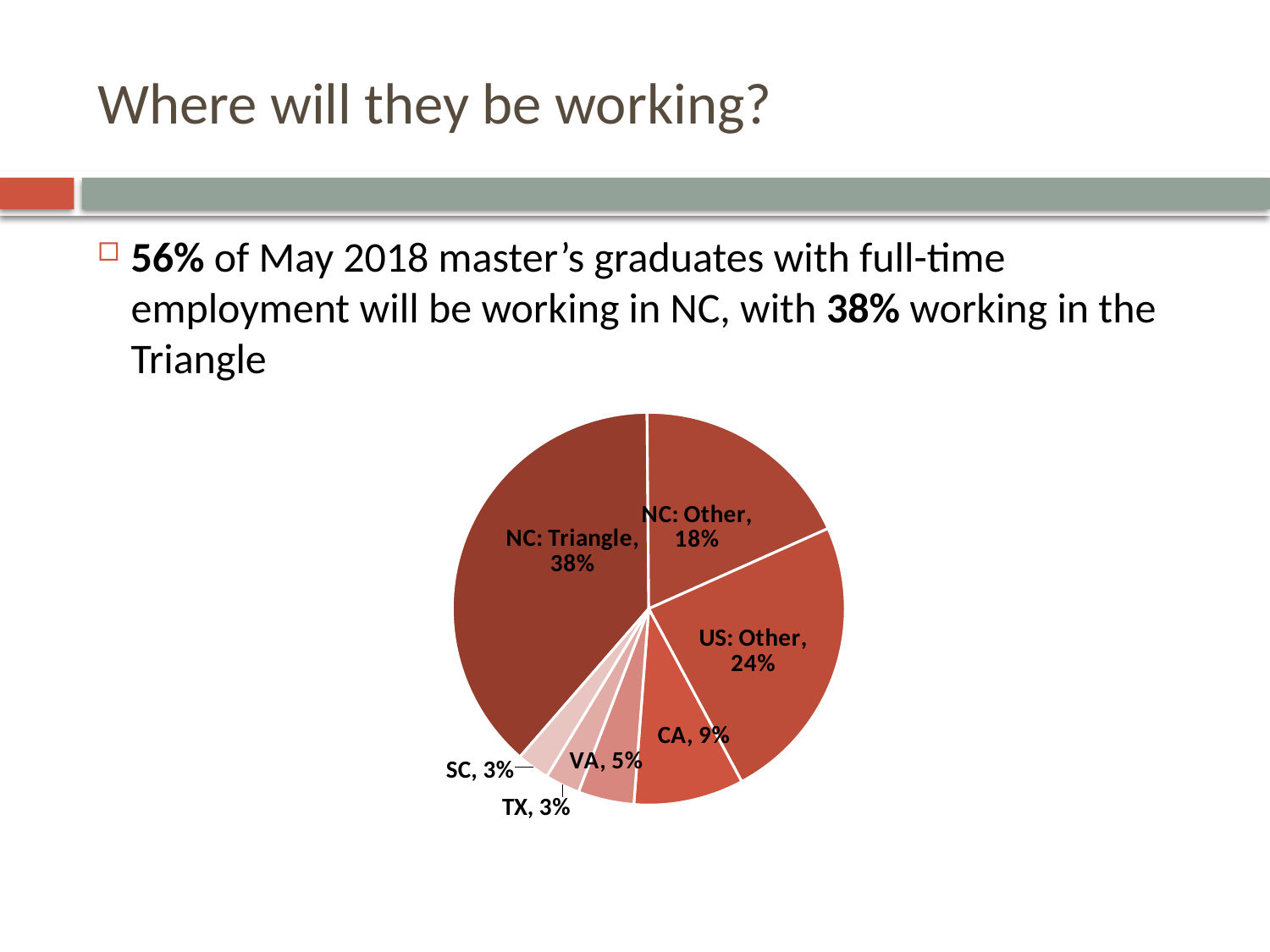
Which is larger, the NC: Other slice or the CA slice? NC: Other Which two slices are each labelled 3%? SC and TX What percentage is shown for NC: Other? 18% Which slice of the pie is the largest? NC: Triangle What type of chart is shown on the slide? pie chart What percentage is shown for US: Other? 24% What percentage of the pie is labelled NC: Triangle? 38% What is the difference in percentage points between NC: Triangle and US: Other? 14 How many slices does the pie chart have? 7 What percentage is shown for CA? 9% What is the combined percentage of the NC: Triangle and NC: Other slices? 56% What percentage is shown for VA? 5%